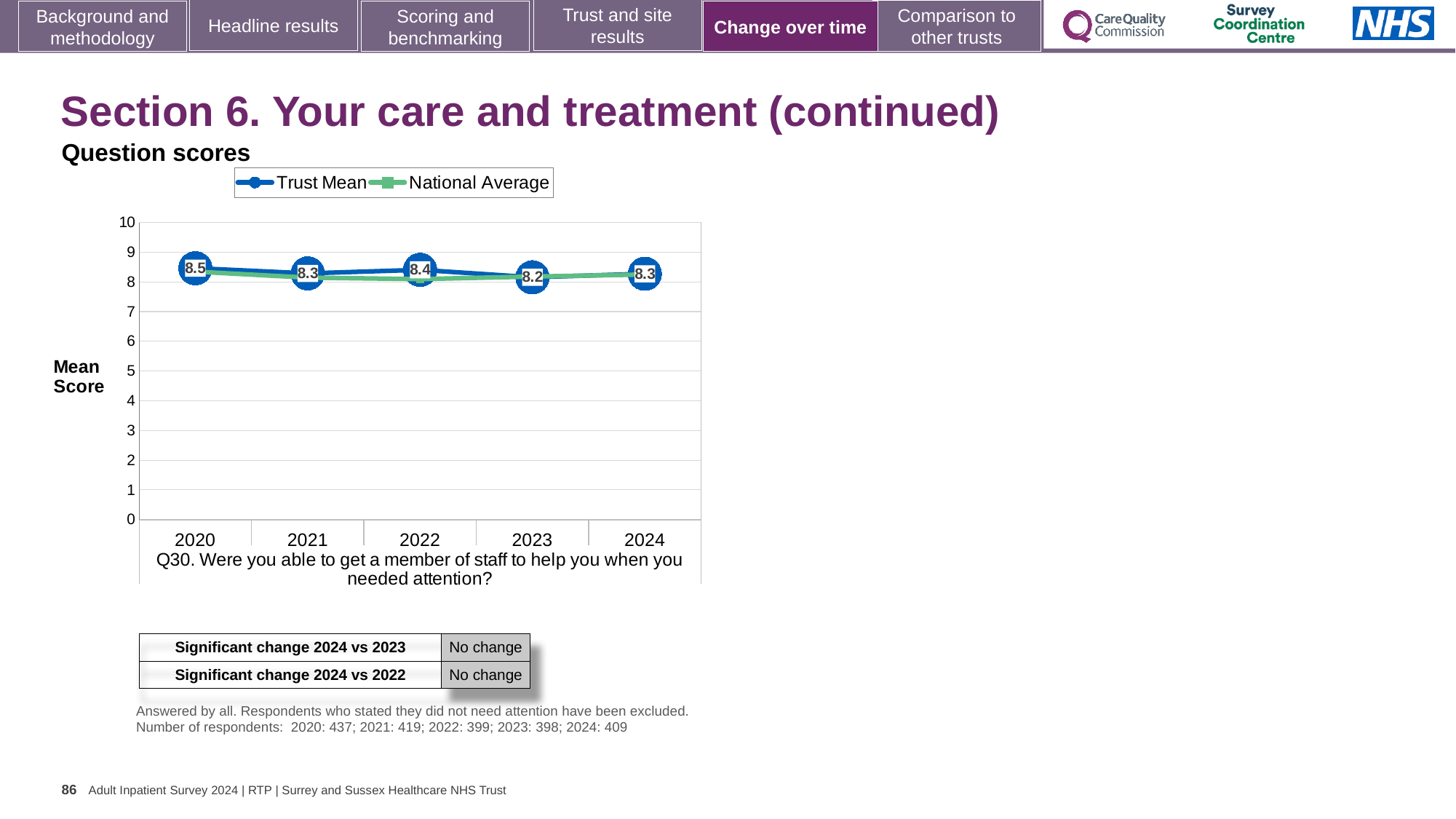
How many series does the legend list? 2 What is the Trust Mean score for 2023? 8.2 How many years are plotted on the x axis? 5 What is the Trust Mean score for 2020? 8.5 What is the Trust Mean score for 2024? 8.3 Which year has the larger Trust Mean, 2021 or 2022? 2022 What is the difference between the Trust Mean in 2020 and in 2023? 0.3 In which year is the Trust Mean highest? 2020 What kind of chart is shown? Line chart Is the National Average value for 2021 greater or less than 7? greater Between 2022 and 2023, does the Trust Mean rise or fall? Fall In which year is the Trust Mean lowest? 2023